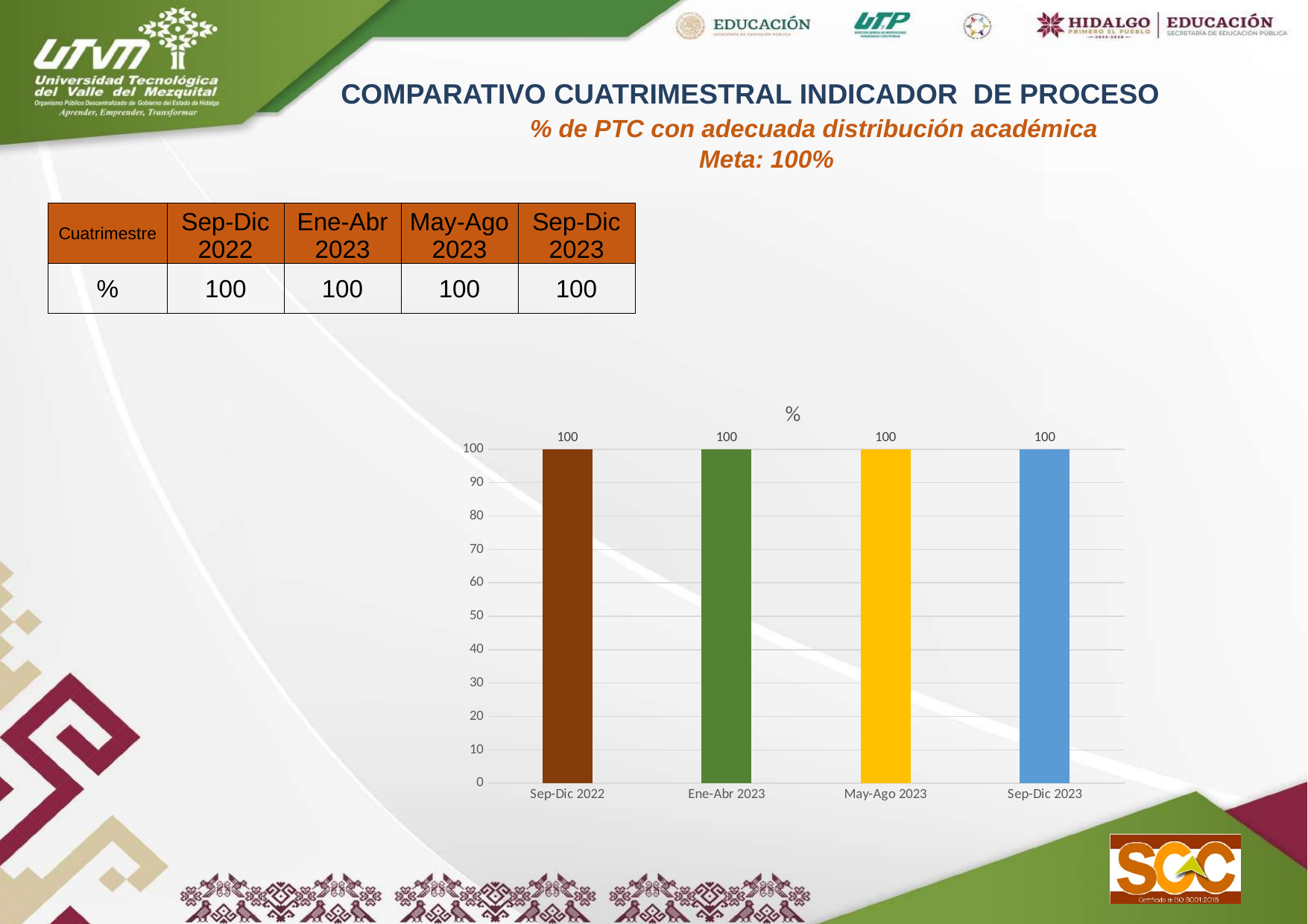
What is the value for May-Ago 2023 in the chart? 100 Is the value for May-Ago 2023 greater or less than 50? greater What is the difference between the values for Sep-Dic 2022 and Sep-Dic 2023? 0 What is the value for Ene-Abr 2023 in the chart? 100 What is the value for Sep-Dic 2022 in the chart? 100 What is the highest tick value shown on the y axis of the chart? 100 What is the label of the first category on the x axis? Sep-Dic 2022 Do the values rise, fall, or stay the same from Sep-Dic 2022 to Sep-Dic 2023? stay the same What is the value for Sep-Dic 2023 in the chart? 100 How many categories are shown on the x axis of the chart? 4 What kind of chart is shown on the slide? bar chart What is the title of the chart? %